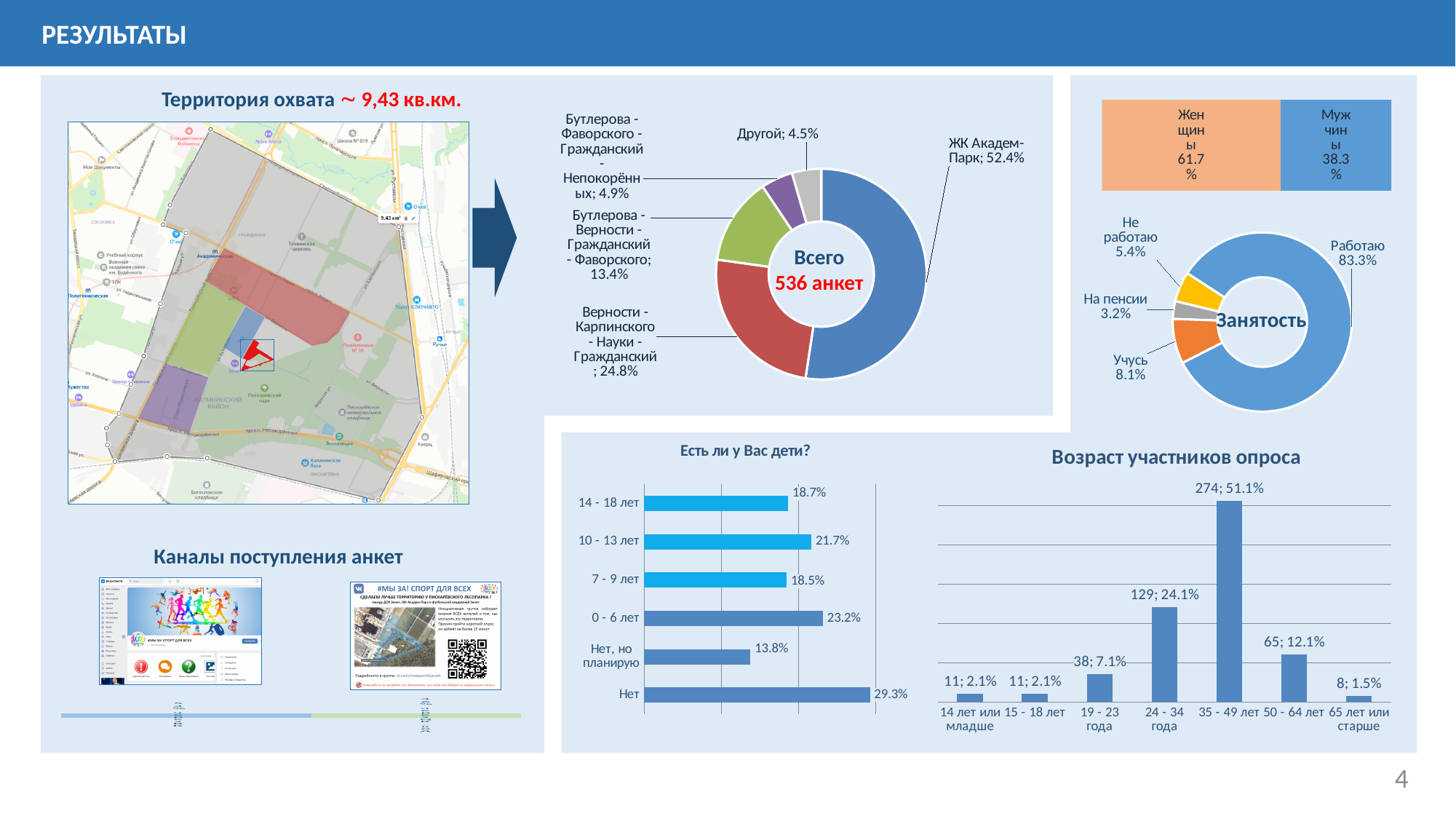
In the 'Есть ли у Вас дети?' chart, which category has the highest value? Нет In the 'Возраст участников опроса' chart, what is the difference in count between '24 - 34 года' and '50 - 64 лет'? 64 In the 'Возраст участников опроса' chart, what is the value for '35 - 49 лет'? 274; 51.1% In the gender bar at the top right, what is the share of 'Женщины'? 61.7% In the 'Есть ли у Вас дети?' chart, what is the value for '0 - 6 лет'? 23.2% In the 'Есть ли у Вас дети?' chart, which is larger: '10 - 13 лет' or '14 - 18 лет'? 10 - 13 лет In the 'Возраст участников опроса' chart, which age group has the lowest value? 65 лет или старше In the 'Возраст участников опроса' chart, how many age categories are shown? 7 In the 'Всего 536 анкет' donut chart, what is the share for 'ЖК Академ-Парк'? 52.4% In the 'Занятость' donut chart, which category has the smallest share? На пенсии In the 'Занятость' donut chart, what is the share for 'Работаю'? 83.3% What type of chart is 'Есть ли у Вас дети?'? Bar chart